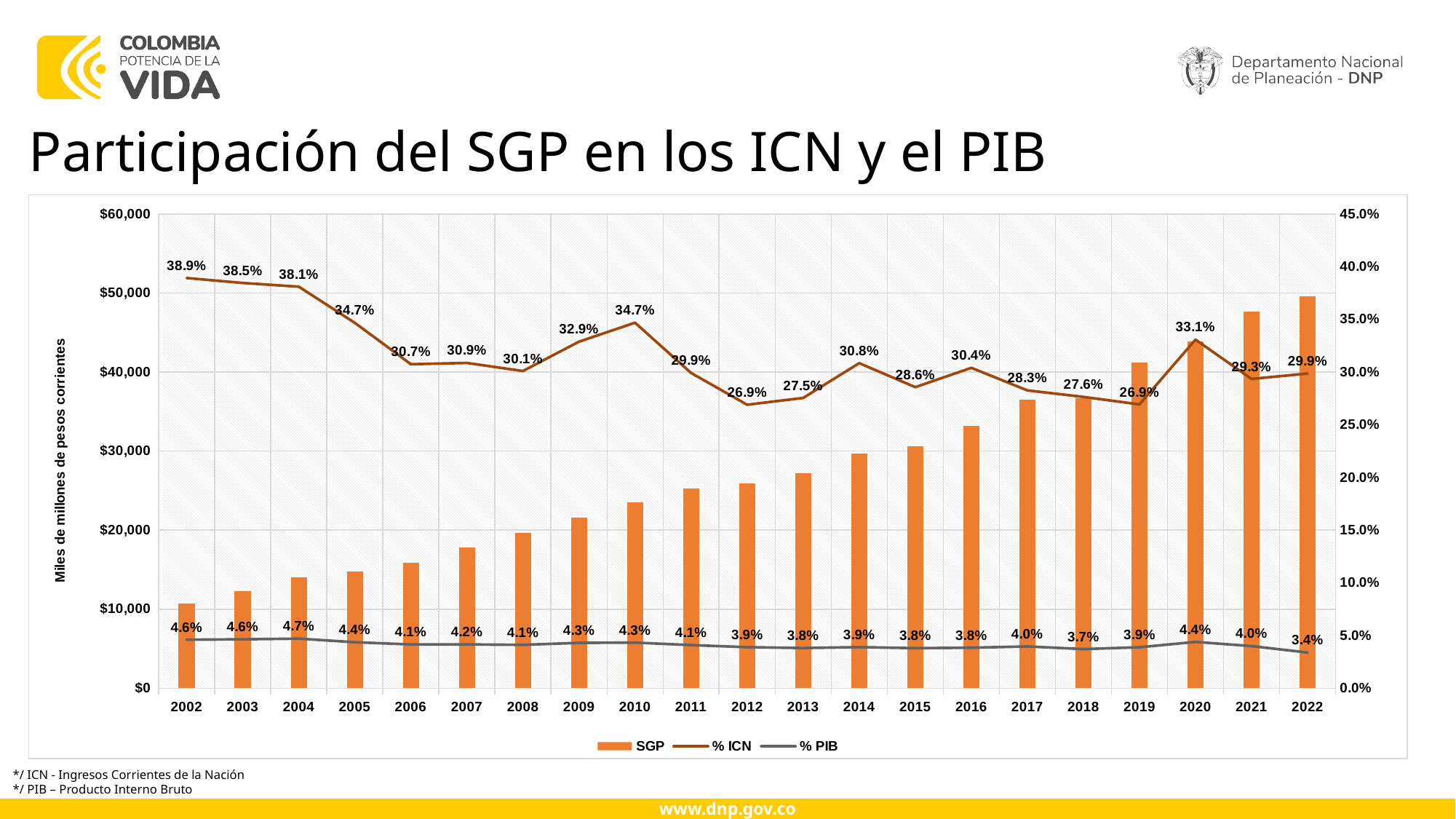
Which is larger, the % ICN value for 2010 or for 2011? 2010 In which year is the % PIB value highest? 2004 In which year is the % PIB value lowest? 2022 How many series does the legend list? 3 How many years are shown on the x axis? 21 What is the % PIB value for 2022? 3.4% Is the SGP value for 2012 greater or less than $30,000? less Is the SGP value for 2022 greater or less than $40,000? greater What is the % ICN value for 2020? 33.1% What is the difference between the % ICN value in 2002 and in 2022? 9.0 percentage points What is the % ICN value for 2002? 38.9% In which year is the % ICN value highest? 2002